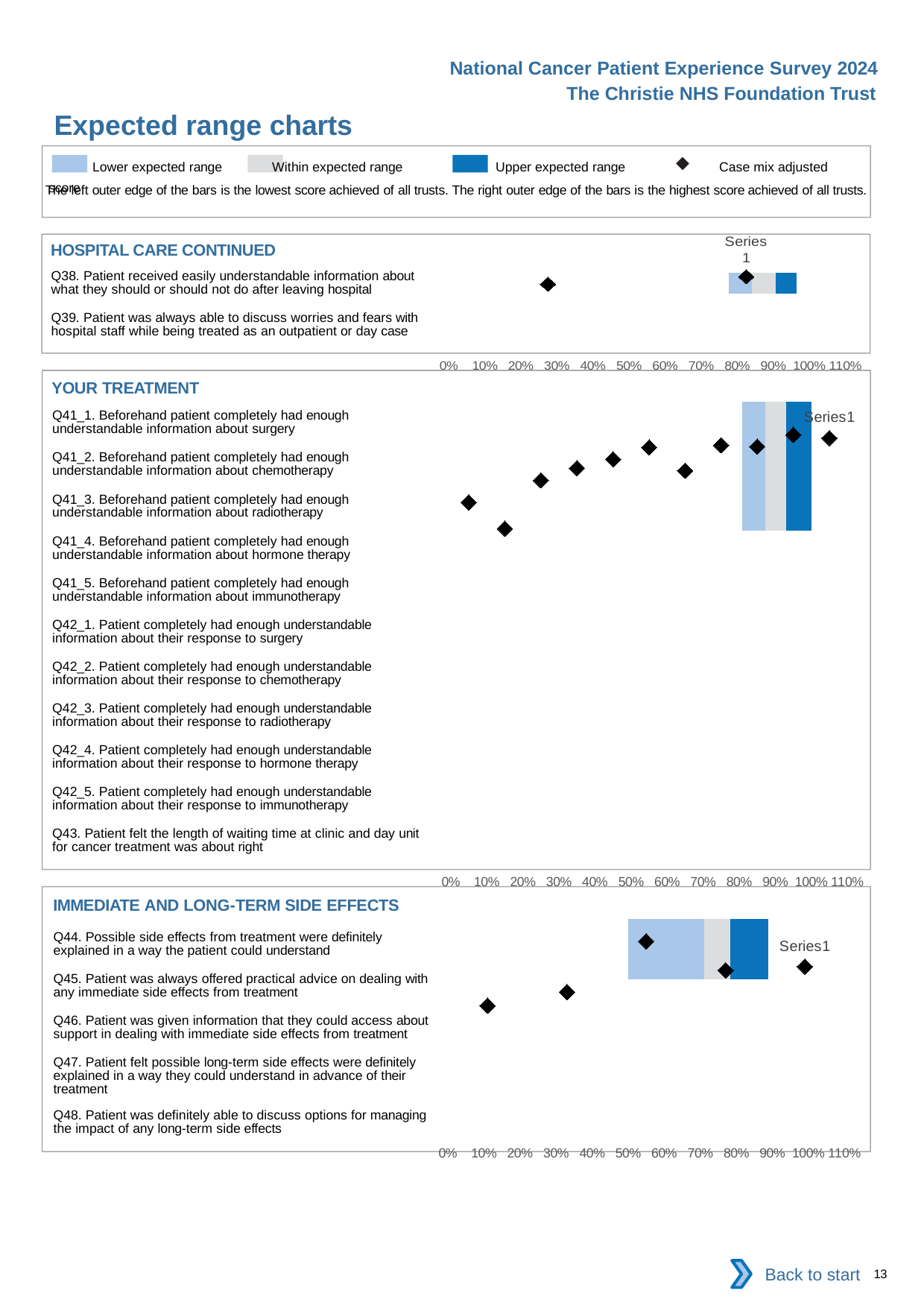
How many entries does the legend at the top of the slide list? 4 What is the lowest tick label shown on the x axis of the charts? 0% How many questions (categories) are listed in the HOSPITAL CARE CONTINUED chart? 2 How many questions (categories) are listed in the IMMEDIATE AND LONG-TERM SIDE EFFECTS chart? 5 What is the highest tick label shown on the x axis of the charts? 110% What symbol does the legend use for the case mix adjusted score? A diamond What kind of chart is used for the expected ranges on this slide? Bar chart What is the title of the middle chart on the slide? YOUR TREATMENT How many questions (categories) are listed in the YOUR TREATMENT chart? 11